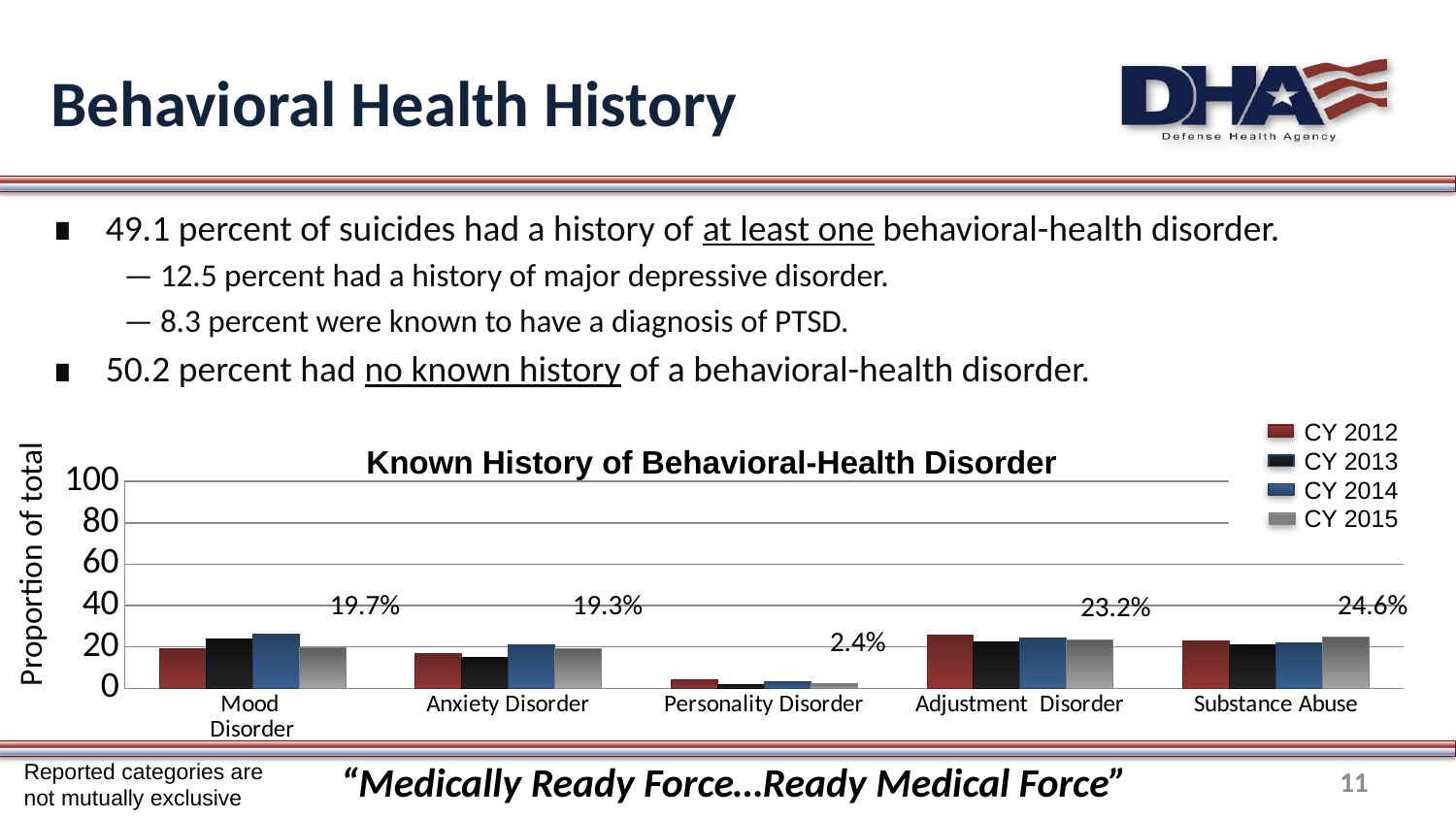
What is the labeled value for Adjustment Disorder in the chart? 23.2% Is the CY 2014 value for Mood Disorder greater or less than 20? greater How many series does the legend of the chart list? 4 What is the title of the chart? Known History of Behavioral-Health Disorder What kind of chart is shown on the slide? bar chart Which labeled value is larger, Mood Disorder or Anxiety Disorder? Mood Disorder Among the labeled values in the chart, which category has the highest value? Substance Abuse What is the labeled value for Personality Disorder in the chart? 2.4% How many disorder categories are shown on the x axis of the chart? 5 Among the labeled values in the chart, which category has the lowest value? Personality Disorder What is the labeled value for Substance Abuse in the chart? 24.6% What is the difference between the labeled values for Substance Abuse (24.6%) and Adjustment Disorder (23.2%)? 1.4%